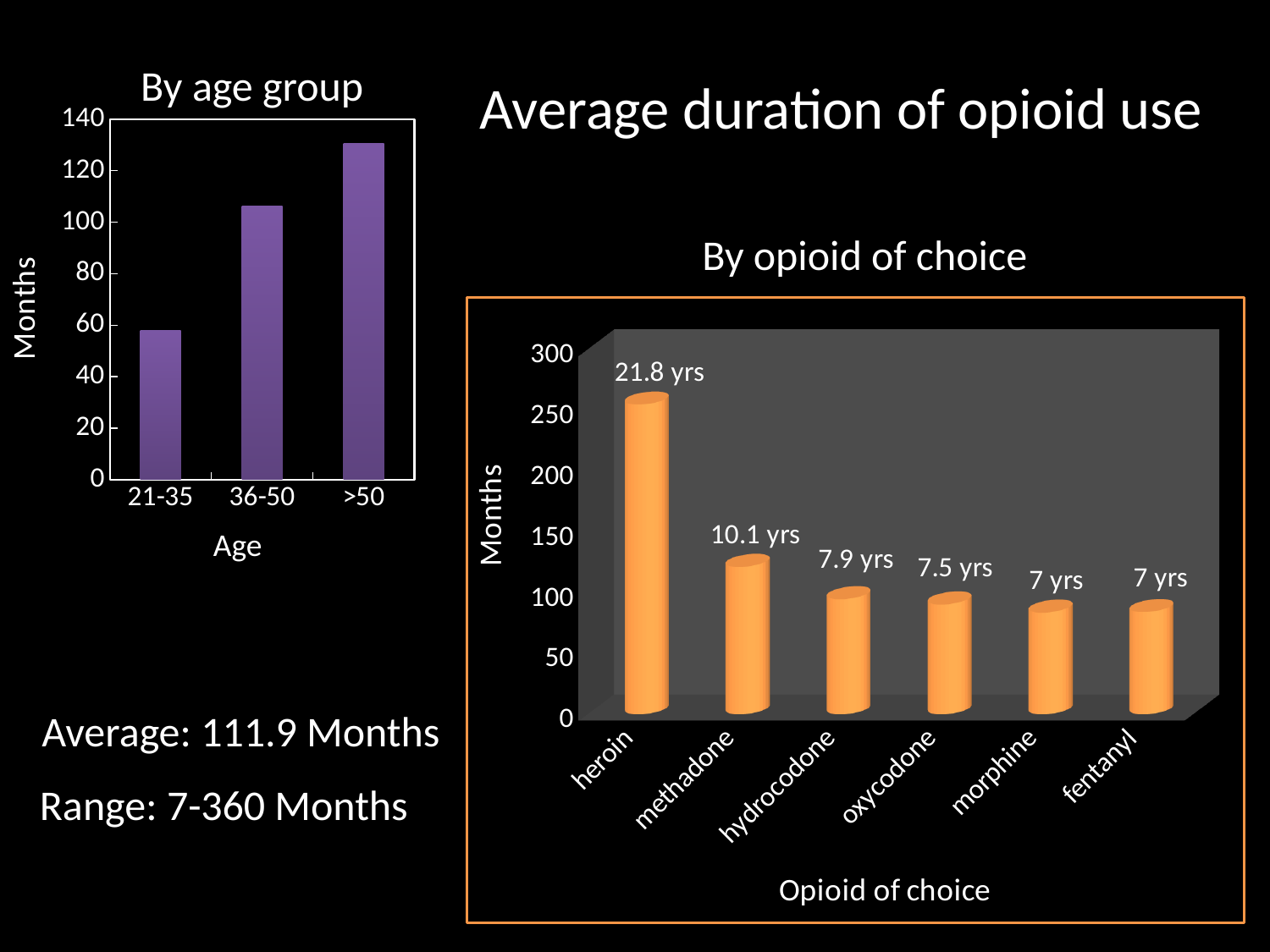
In the 'By opioid of choice' chart, what is the difference between the labelled values for heroin and methadone? 11.7 yrs In the 'By opioid of choice' chart, what is the value labelled for heroin? 21.8 yrs What kind of chart is the 'By age group' chart? bar chart In the 'By age group' chart, is the value for the 36-50 age group greater or less than 100? greater In the 'By age group' chart, is the value for the 21-35 age group greater or less than 40? greater In the 'By age group' chart, which age group has the highest average duration of use? >50 In the 'By opioid of choice' chart, which opioid has the highest average duration of use? heroin In the 'By opioid of choice' chart, what is the value labelled for methadone? 10.1 yrs In the 'By opioid of choice' chart, what is the value labelled for oxycodone? 7.5 yrs In the 'By opioid of choice' chart, do the values rise or fall from left to right along the x axis? fall In the 'By opioid of choice' chart, which has the larger value, hydrocodone or oxycodone? hydrocodone How many opioid categories are shown in the 'By opioid of choice' chart? 6